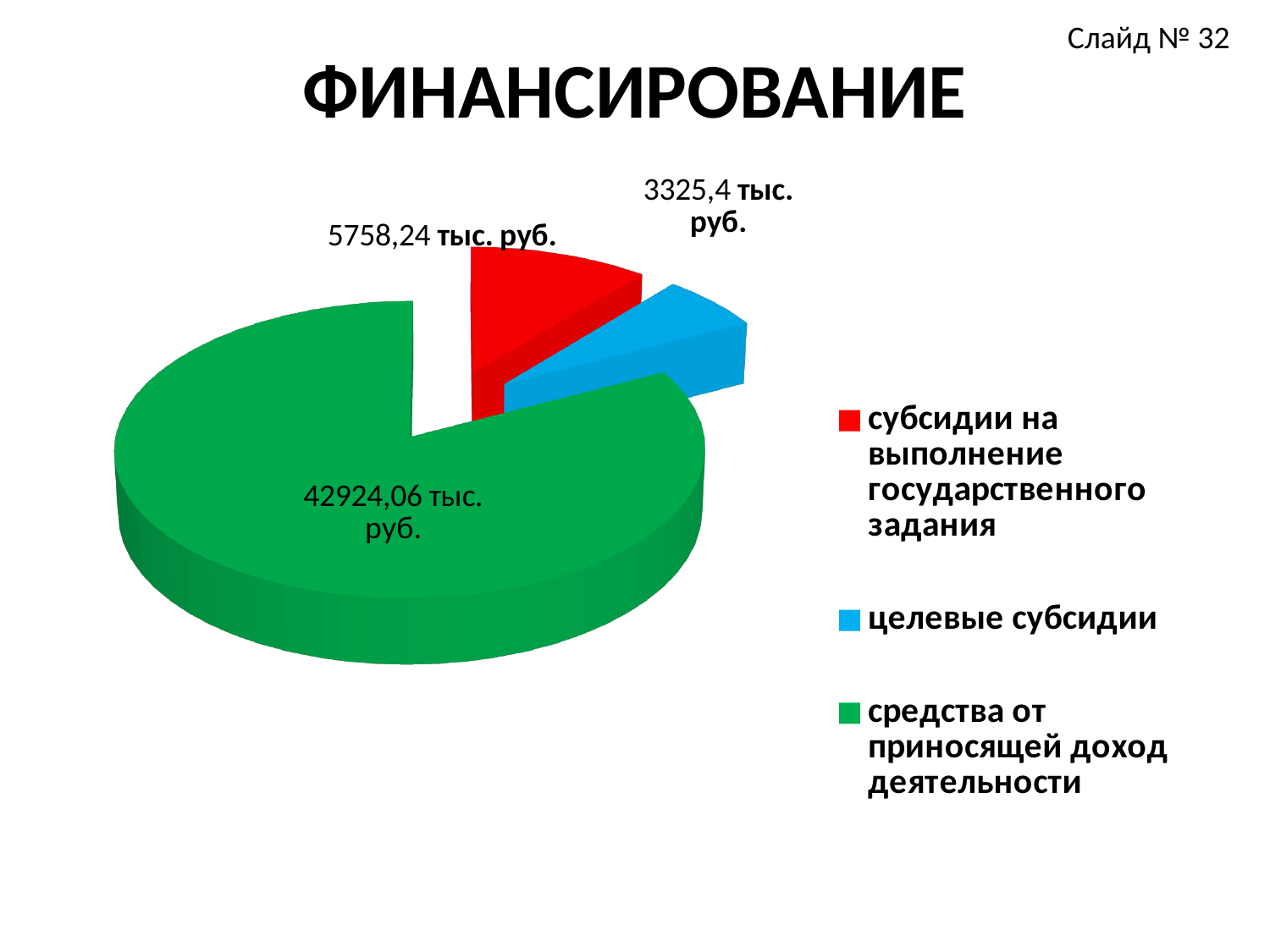
What is the total of all three slices of the pie? 52007,7 тыс. руб. Which is larger: 'субсидии на выполнение государственного задания' or 'целевые субсидии'? субсидии на выполнение государственного задания Which category has the largest slice of the pie? средства от приносящей доход деятельности What is the value for 'целевые субсидии'? 3325,4 тыс. руб. What is the value for 'субсидии на выполнение государственного задания'? 5758,24 тыс. руб. What is the difference between 'субсидии на выполнение государственного задания' and 'целевые субсидии'? 2432,84 тыс. руб. What is the title of the chart on the slide? ФИНАНСИРОВАНИЕ What is the value for 'средства от приносящей доход деятельности'? 42924,06 тыс. руб. Which category has the smallest slice of the pie? целевые субсидии Which colour represents 'целевые субсидии' in the legend? Blue How many slices does the pie chart have? 3 What kind of chart is shown on the slide? Pie chart